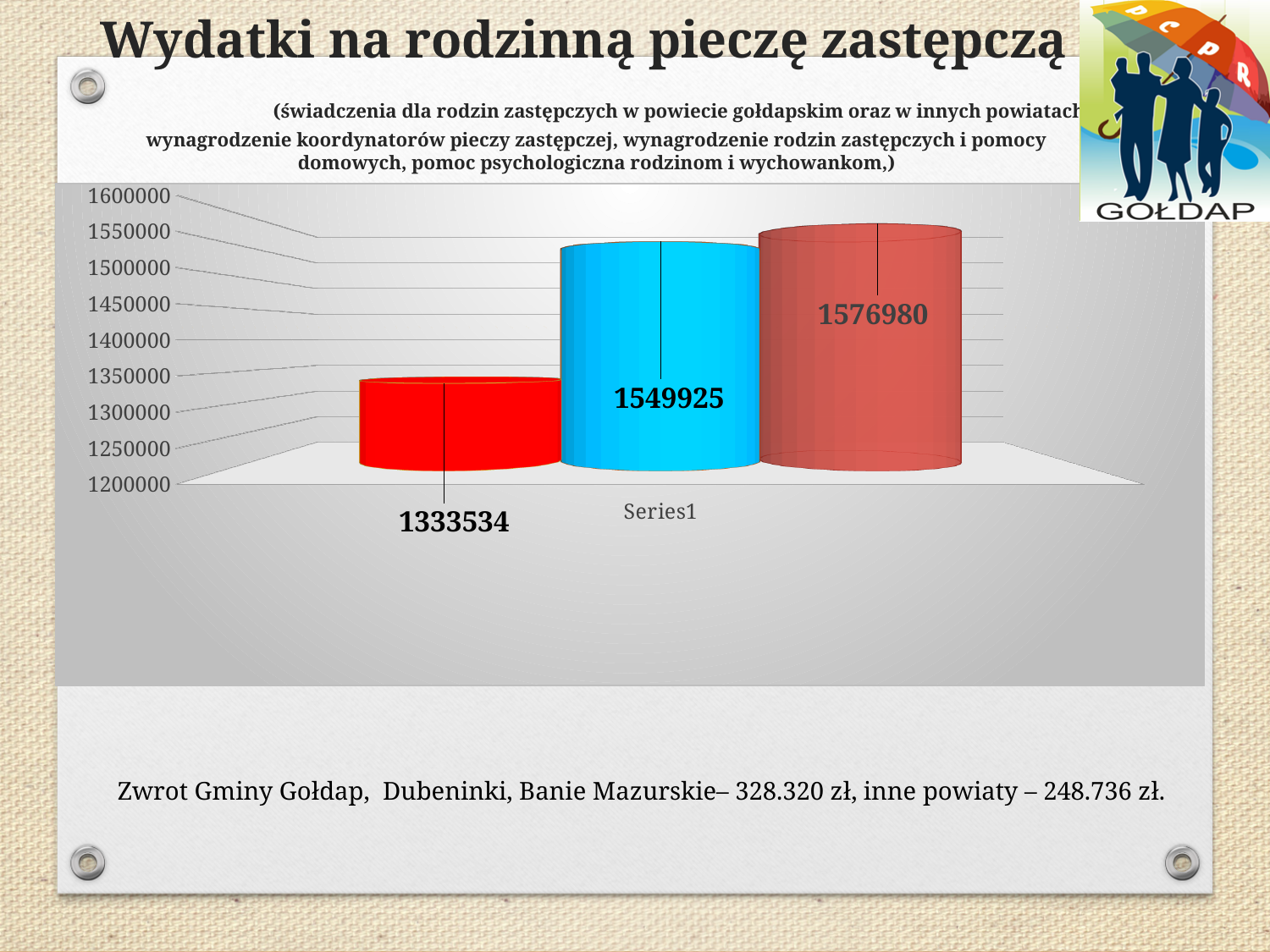
Is the value of the leftmost bar greater or less than 1400000? less How many bars are plotted on the chart? 3 What value is labelled on the middle (blue) bar of the chart? 1549925 Which is larger, the value of the leftmost bar or the value of the middle bar? the middle bar (1549925) What is the highest value shown on the chart? 1576980 What is the difference between the middle bar (1549925) and the leftmost bar (1333534)? 216391 What value is labelled on the leftmost (red) bar of the chart? 1333534 What value is labelled on the rightmost (dark red) bar of the chart? 1576980 What is the difference between the rightmost bar (1576980) and the middle bar (1549925)? 27055 Do the bar values rise or fall from left to right across the chart? rise What is the lowest value shown on the chart? 1333534 What kind of chart is shown on the slide? bar chart